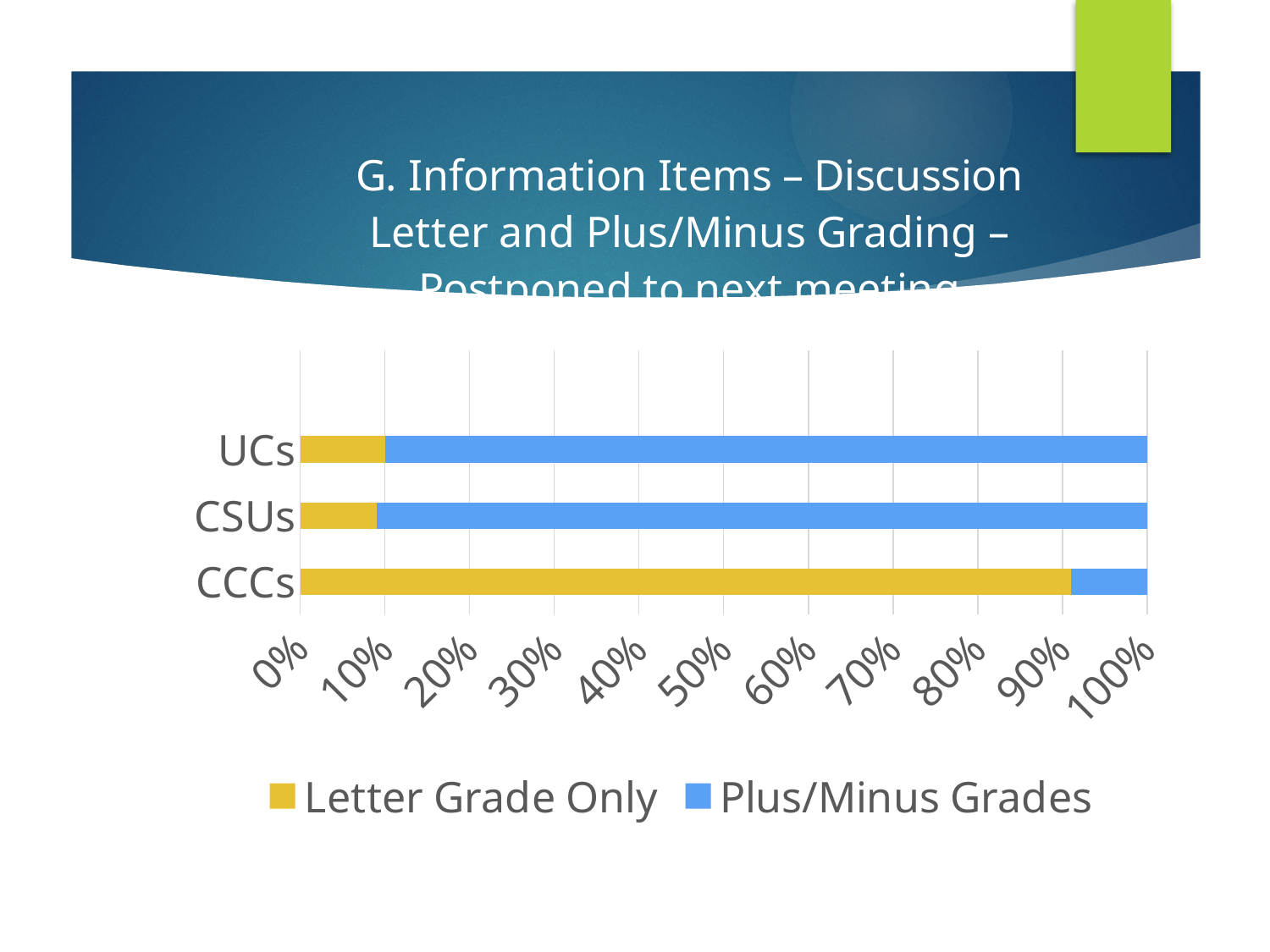
Is the Letter Grade Only value for CCCs greater or less than 80%? greater How many categories are plotted on the chart? 3 Is the Letter Grade Only value for CSUs greater or less than 30%? less Which is larger for Letter Grade Only: CCCs or UCs? CCCs Which series is shown in blue in the legend? Plus/Minus Grades Which category has the lowest value for Plus/Minus Grades? CCCs Which series is shown in yellow in the legend? Letter Grade Only Which category has the highest value for Letter Grade Only? CCCs Which is larger for Plus/Minus Grades: UCs or CCCs? UCs How many series does the chart legend list? 2 What kind of chart is shown on the slide? bar chart Is the Letter Grade Only value for UCs greater or less than 20%? less